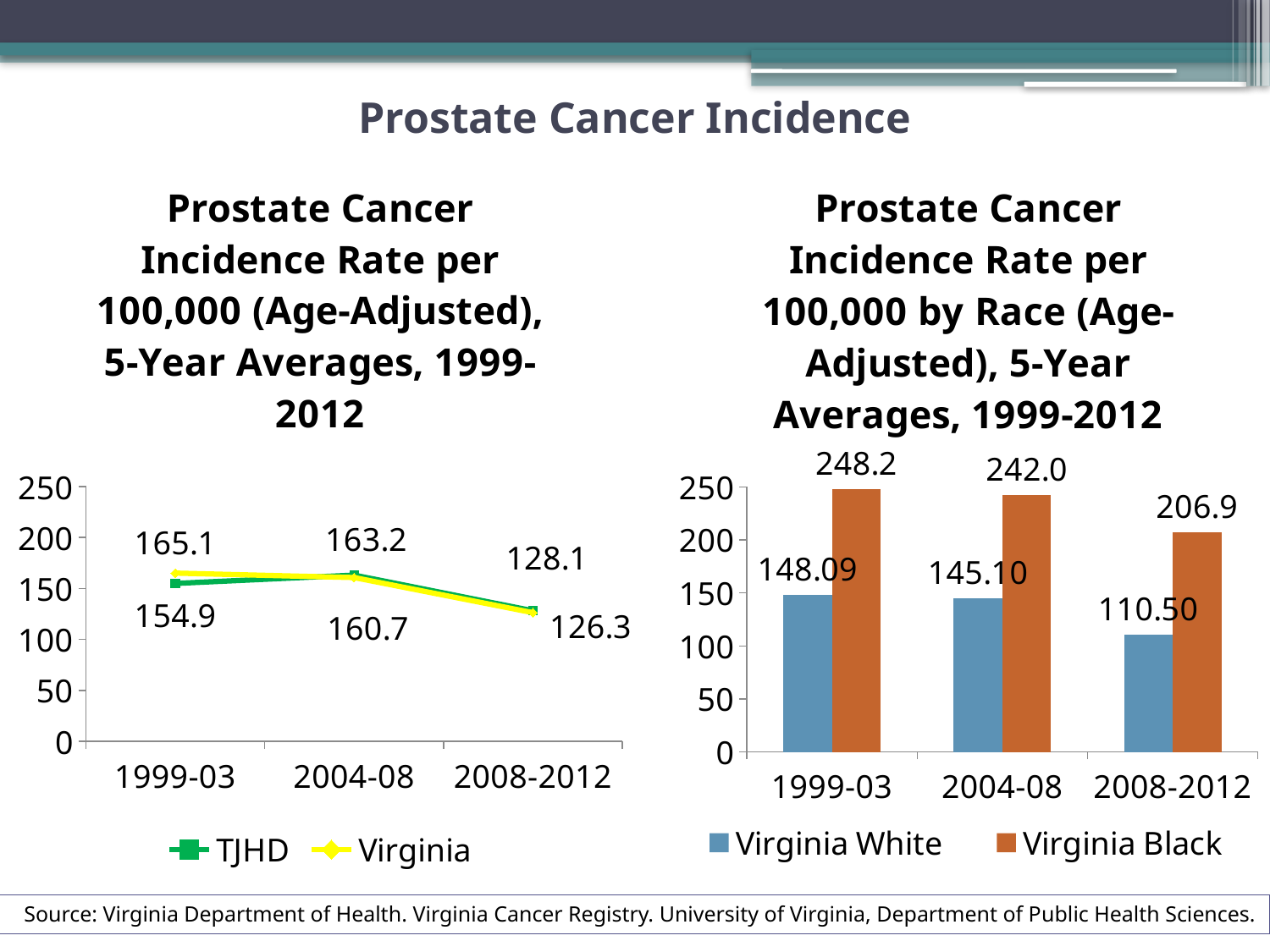
In the right-hand chart by race, what is the incidence rate for Virginia White in 2008-2012? 110.50 In the right-hand chart by race, what is the difference between the Virginia Black and Virginia White rates in 1999-03? 100.11 In the left-hand line chart, what is the TJHD incidence rate for 1999-03? 154.9 What kind of chart is the right-hand chart, 'Prostate Cancer Incidence Rate per 100,000 by Race'? Bar chart In the right-hand chart by race, in which period is the Virginia White rate lowest? 2008-2012 How many series does the legend of the right-hand chart by race list? 2 In the left-hand line chart, do the rates rise or fall from 2004-08 to 2008-2012? Fall In the left-hand line chart, what is the Virginia incidence rate for 1999-03? 165.1 What kind of chart is the left-hand chart, 'Prostate Cancer Incidence Rate per 100,000 (Age-Adjusted)'? Line chart In the right-hand chart by race, in which period is the Virginia Black rate highest? 1999-03 In the right-hand chart by race, what is the incidence rate for Virginia Black in 1999-03? 248.2 In the right-hand chart by race, which is larger: Virginia Black in 2008-2012 or Virginia White in 1999-03? Virginia Black in 2008-2012